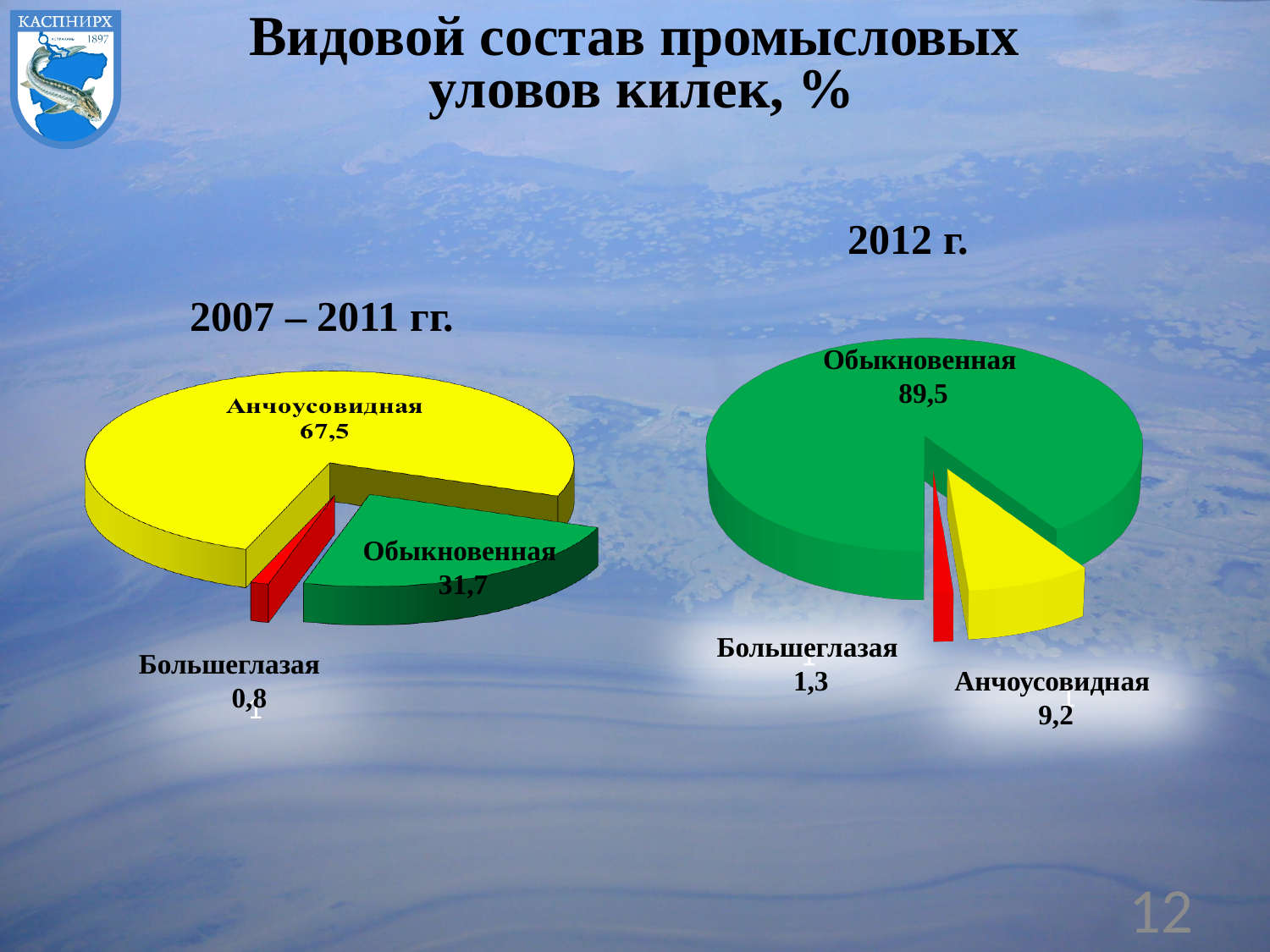
In the 2007 – 2011 гг. pie chart, what is the value for Обыкновенная? 31,7 How many categories does the 2012 г. pie chart show? 3 In the 2007 – 2011 гг. pie chart, what is the difference between Анчоусовидная and Обыкновенная? 35,8 In the 2012 г. pie chart, what is the value for Анчоусовидная? 9,2 In the 2012 г. pie chart, what is the value for Обыкновенная? 89,5 In the 2012 г. pie chart, which category has the smallest share? Большеглазая What type of chart is used on this slide? Pie chart In the 2007 – 2011 гг. pie chart, which category has the largest share? Анчоусовидная In the 2007 – 2011 гг. pie chart, what is the value for Большеглазая? 0,8 In the 2012 г. pie chart, which is larger, Анчоусовидная or Большеглазая? Анчоусовидная In the 2007 – 2011 гг. pie chart, what is the value for Анчоусовидная? 67,5 In the 2012 г. pie chart, what is the value for Большеглазая? 1,3